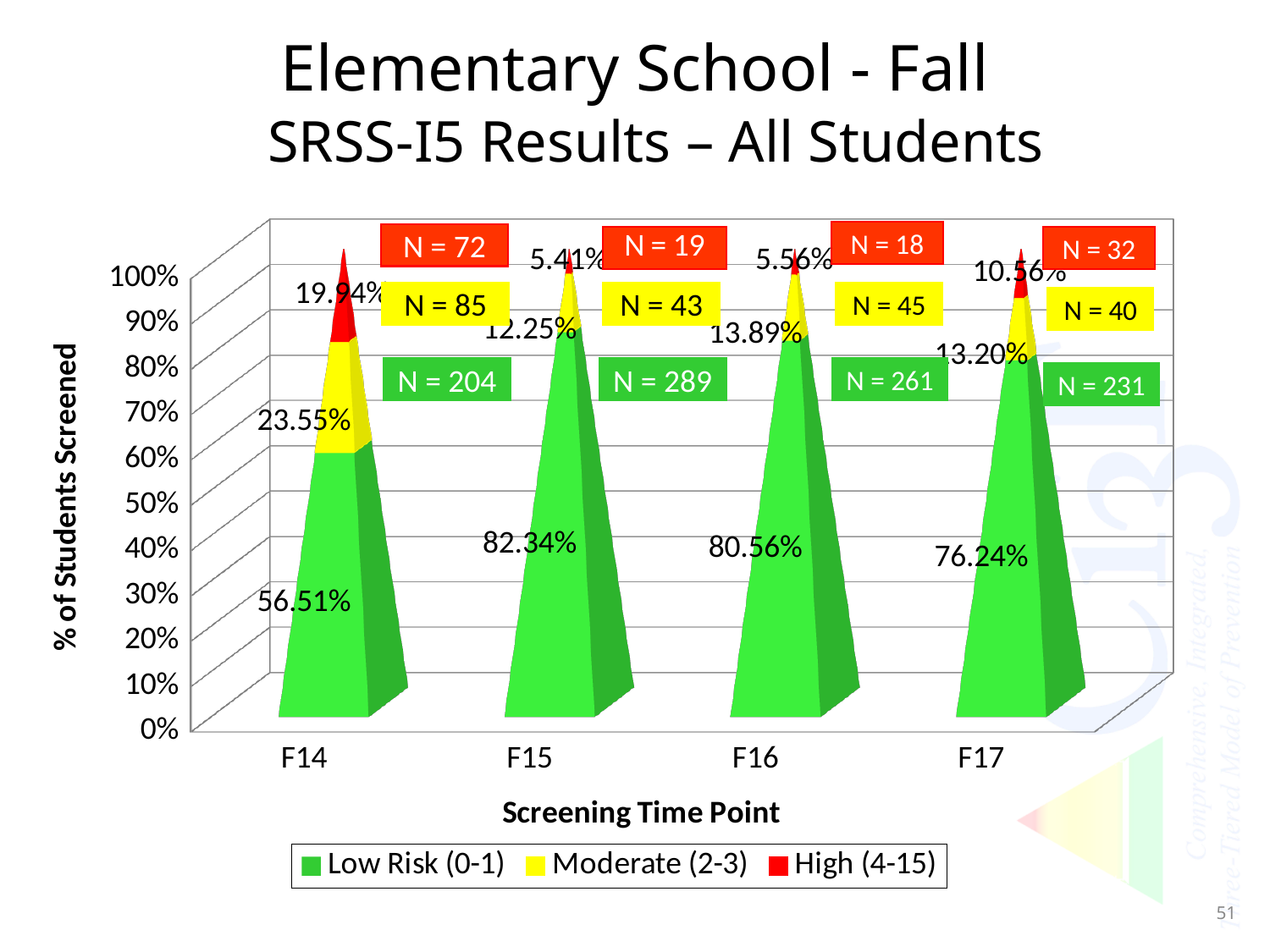
What percentage of students screened at F16 were in the Moderate (2-3) category? 13.89% Does the Low Risk (0-1) percentage rise or fall from F15 to F17? Fall How many series does the legend list? 3 Which screening time point has the highest Low Risk (0-1) percentage? F15 What kind of chart is shown on the slide? Stacked bar chart According to the N label, how many students were in the Low Risk group at F15? N = 289 Which screening time point has the lowest Low Risk (0-1) percentage? F14 What percentage of students screened at F17 were in the High (4-15) category? 10.56% Which has a larger Moderate (2-3) percentage, F15 or F16? F16 What percentage of students screened at F14 were in the Low Risk (0-1) category? 56.51% How many screening time points are shown on the x axis? 4 What is the difference in percentage points between the Low Risk (0-1) value at F15 and at F14? 25.83 percentage points